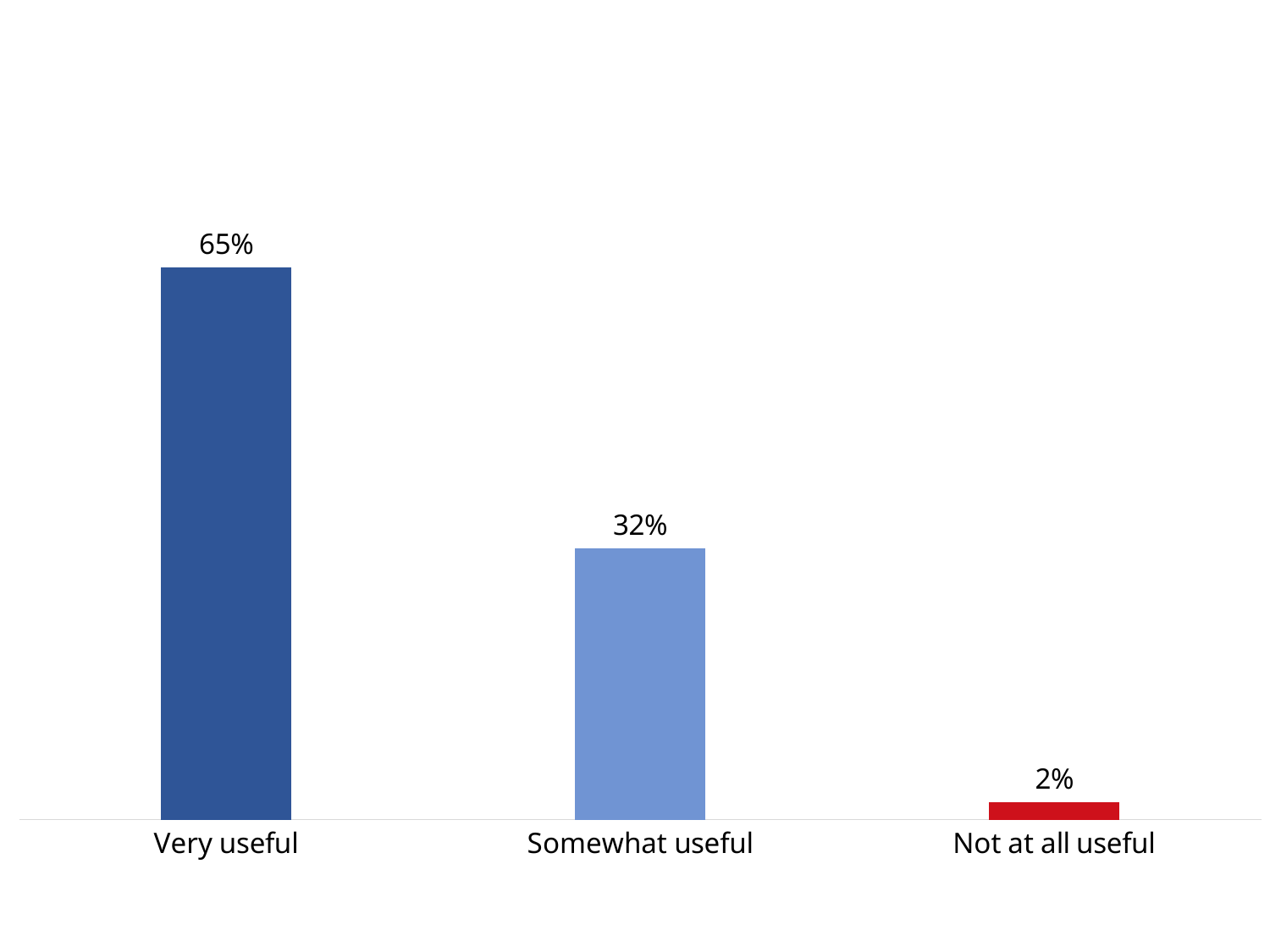
What is the value for Not at all useful? 2% What is the difference between the values for Somewhat useful and Not at all useful? 30% Do the values rise or fall from left to right across the categories? Fall Which category has the lowest value? Not at all useful What is the difference between the values for Very useful and Somewhat useful? 33% How many categories are shown in the chart? 3 Which is larger, the value for Somewhat useful or the value for Not at all useful? Somewhat useful What is the value for Somewhat useful? 32% What colour is the bar for Not at all useful? Red What kind of chart is this? Bar chart What is the value for Very useful? 65% Which category has the highest value? Very useful